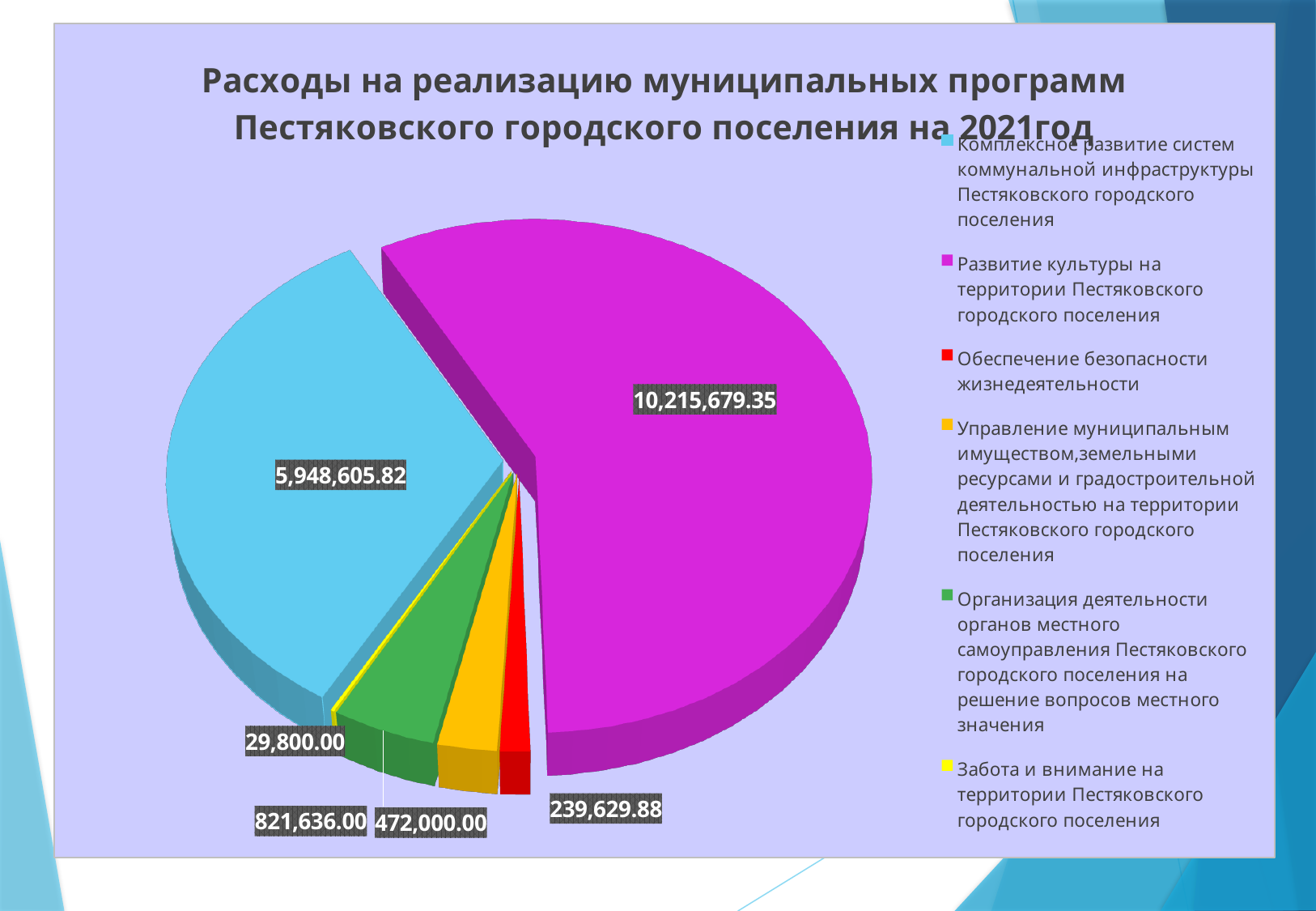
What colour is the slice for «Обеспечение безопасности жизнедеятельности»? red How many slices does the pie chart have? 6 What is the difference between the values for «Развитие культуры» and «Комплексное развитие систем коммунальной инфраструктуры»? 4,267,073.53 What is the value for «Развитие культуры на территории Пестяковского городского поселения»? 10,215,679.35 Which program has the largest expenditure in the pie chart? Развитие культуры на территории Пестяковского городского поселения Which is larger: the value for «Управление муниципальным имуществом...» or the value for «Обеспечение безопасности жизнедеятельности»? Управление муниципальным имуществом... Which program has the smallest expenditure in the pie chart? Забота и внимание на территории Пестяковского городского поселения What is the value for «Забота и внимание на территории Пестяковского городского поселения»? 29,800.00 What is the value for «Комплексное развитие систем коммунальной инфраструктуры Пестяковского городского поселения»? 5,948,605.82 What is the value for «Организация деятельности органов местного самоуправления Пестяковского городского поселения на решение вопросов местного значения»? 821,636.00 What kind of chart is shown on the slide? pie chart What is the value for «Обеспечение безопасности жизнедеятельности»? 239,629.88